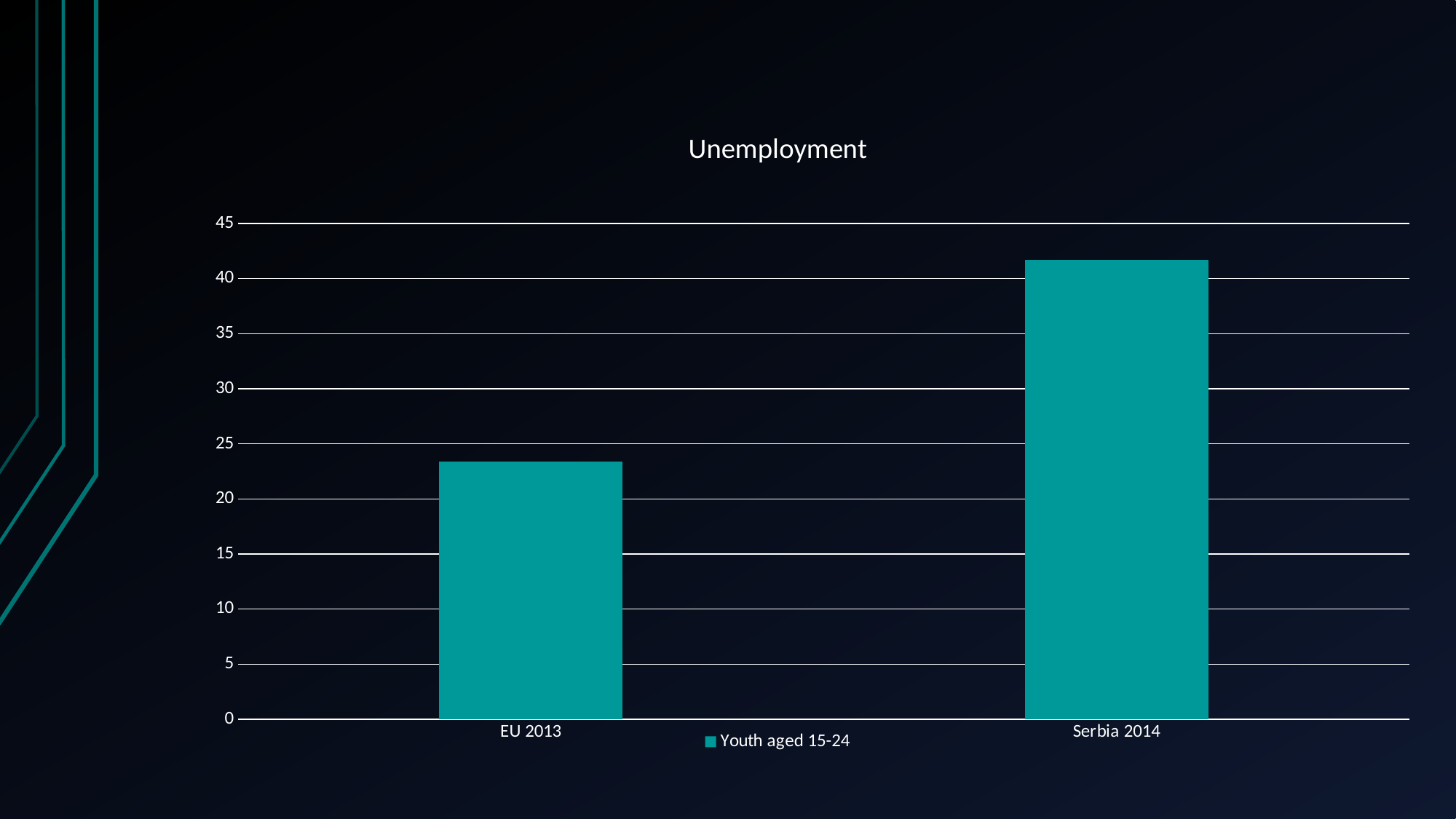
Which is larger, the value for EU 2013 or the value for Serbia 2014? Serbia 2014 How many series does the legend list? 1 Is the value for EU 2013 greater or less than 25? less Which category has the lowest value? EU 2013 Which category has the highest value? Serbia 2014 What series name does the legend show? Youth aged 15-24 How many categories are shown on the x axis? 2 What kind of chart is shown on the slide? bar chart Is the value for EU 2013 greater or less than 20? greater What is the title of the chart? Unemployment Is the value for Serbia 2014 greater or less than 40? greater